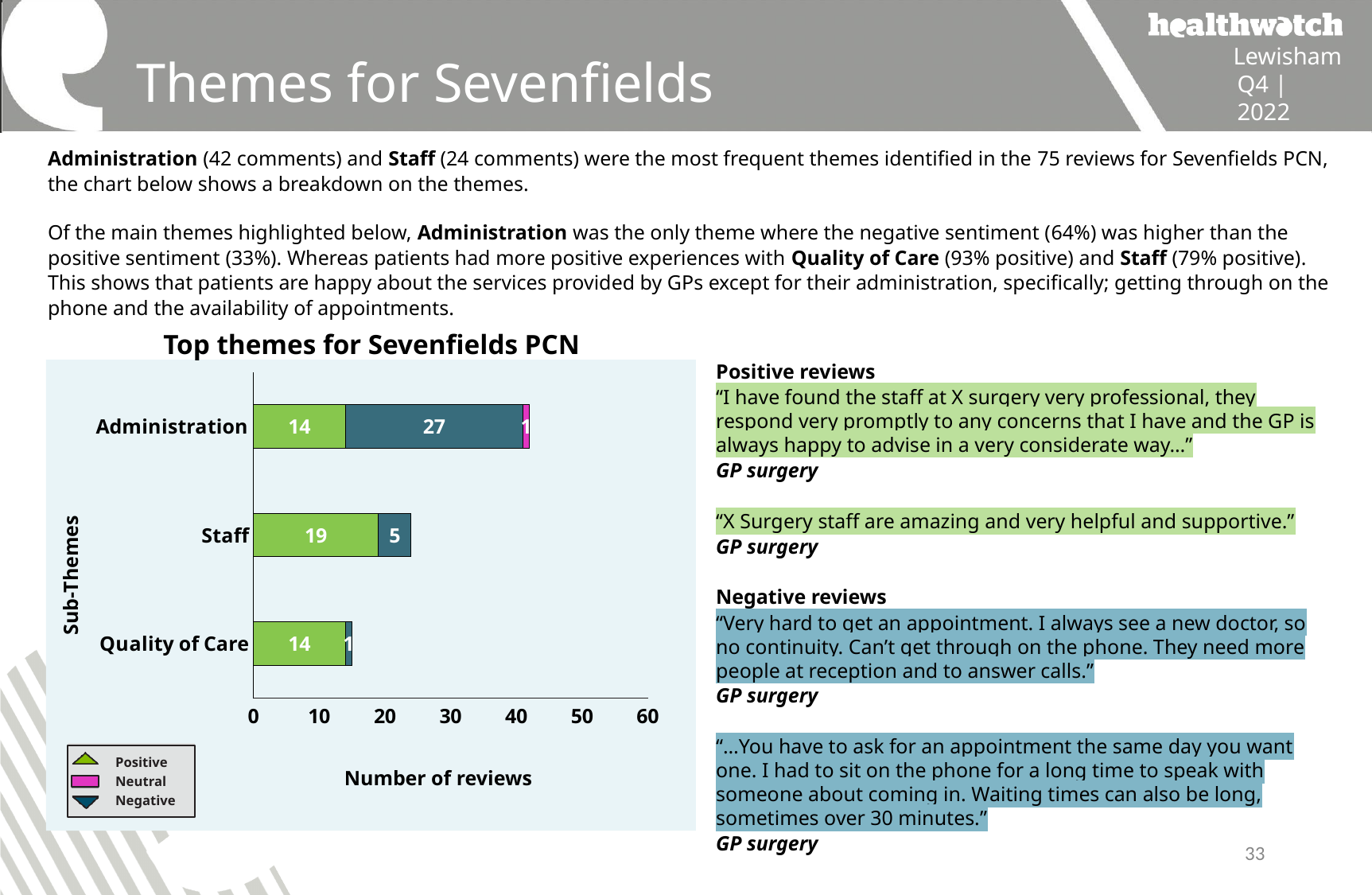
What is the difference between the negative reviews for Administration and the negative reviews for Staff? 22 What is the total number of reviews in the Staff bar? 24 What is the number of negative reviews for Administration? 27 What type of chart is 'Top themes for Sevenfields PCN'? Bar chart Which is larger: the positive reviews for Staff or the positive reviews for Administration? Staff Which sub-theme has the highest number of negative reviews? Administration What is the label on the x axis of the chart? Number of reviews How many sub-themes are shown on the y axis of the chart? 3 How many series does the chart legend list? 3 What is the number of positive reviews for Quality of Care? 14 What is the total number of reviews in the Administration bar? 42 What is the number of positive reviews for Staff? 19